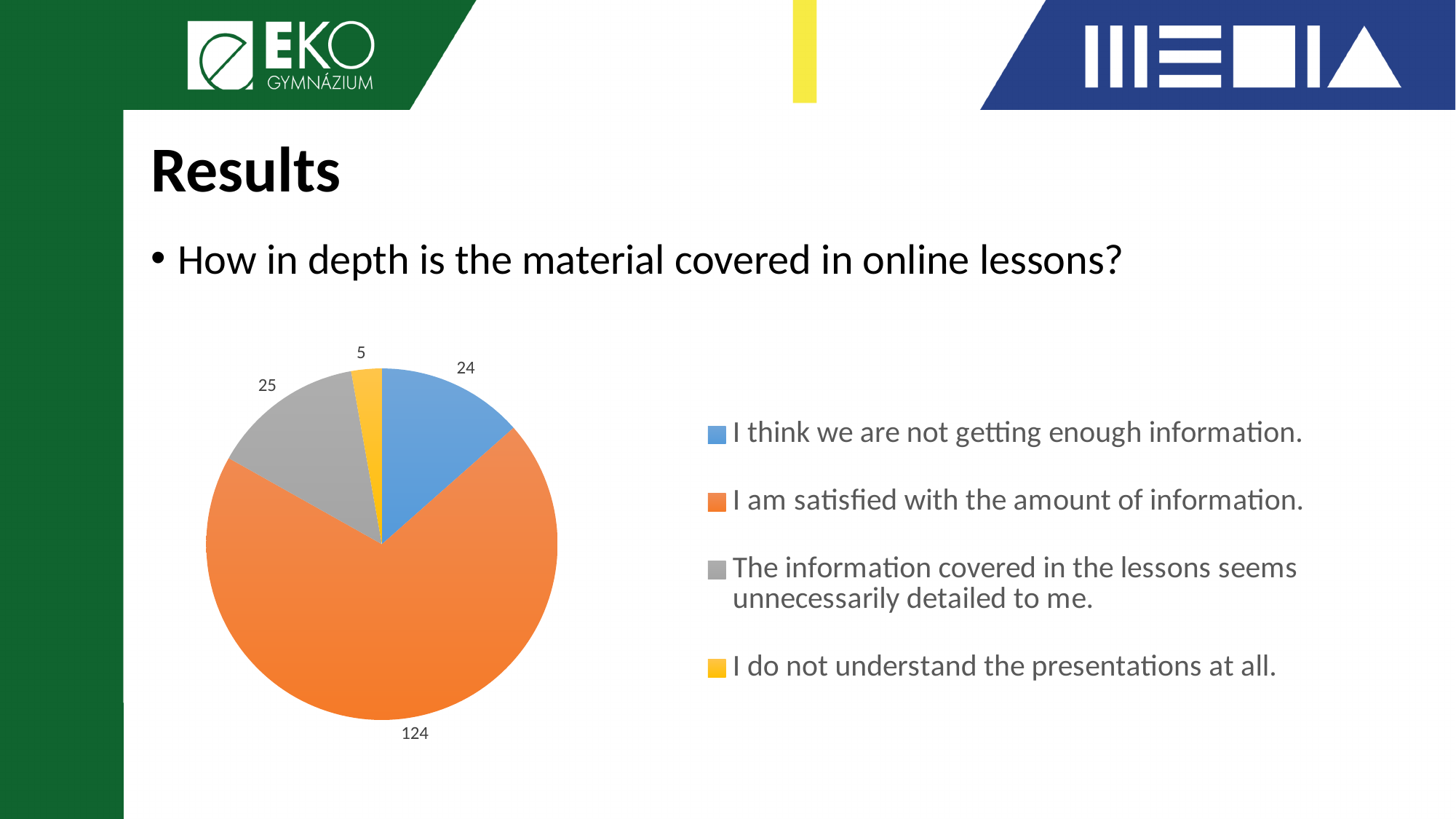
Which response has the largest slice of the pie? I am satisfied with the amount of information. How many respondents said they think they are not getting enough information? 24 How many respondents said the information covered in the lessons seems unnecessarily detailed? 25 Which colour represents the response 'I do not understand the presentations at all.'? Yellow What is the difference between the number of respondents who are satisfied with the amount of information and those who think they are not getting enough information? 100 How many respondents said they do not understand the presentations at all? 5 Which response has the smallest slice of the pie? I do not understand the presentations at all. What is the total number of responses shown in the pie chart? 178 How many respondents said they are satisfied with the amount of information? 124 Which is larger: the number who find the information unnecessarily detailed or the number who think they are not getting enough information? The information covered in the lessons seems unnecessarily detailed to me. How many response categories are shown in the pie chart? 4 What type of chart is shown on the slide? Pie chart